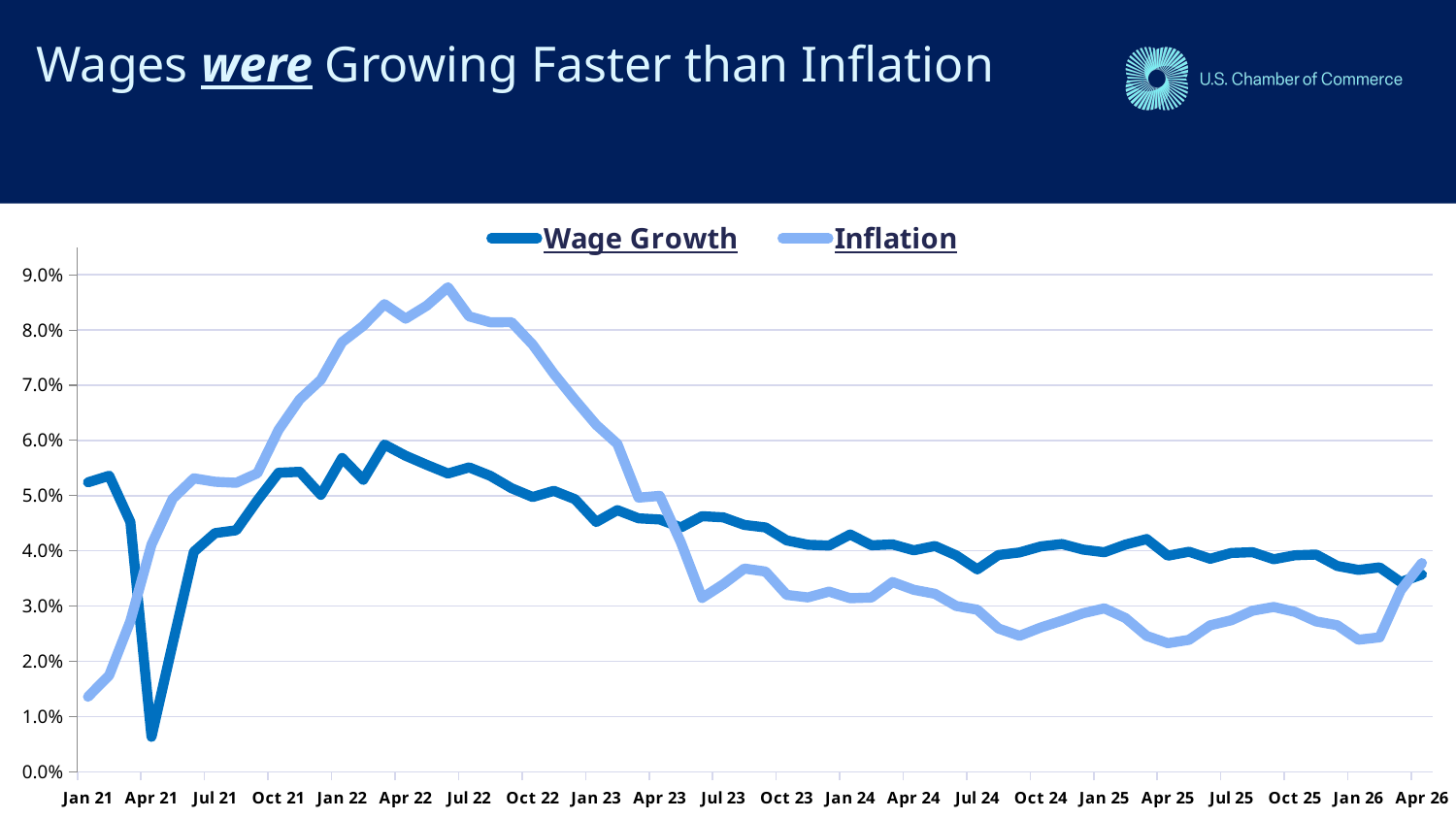
Which series reaches the highest value anywhere on the chart? Inflation At Apr 22, which series is higher, Wage Growth or Inflation? Inflation Is the Inflation value at Jan 21 greater or less than 2.0%? less Is the Inflation value at Apr 22 greater or less than 8.0%? greater Is the Wage Growth value at Apr 21 greater or less than 1.0%? less How many series does the legend list? 2 What are the two series named in the legend? Wage Growth and Inflation At Apr 25, which series is higher, Wage Growth or Inflation? Wage Growth What kind of chart is shown on the slide? Line chart Does the Inflation line rise or fall between Jul 22 and Jul 23? Fall What is the title of the slide containing the chart? Wages were Growing Faster than Inflation